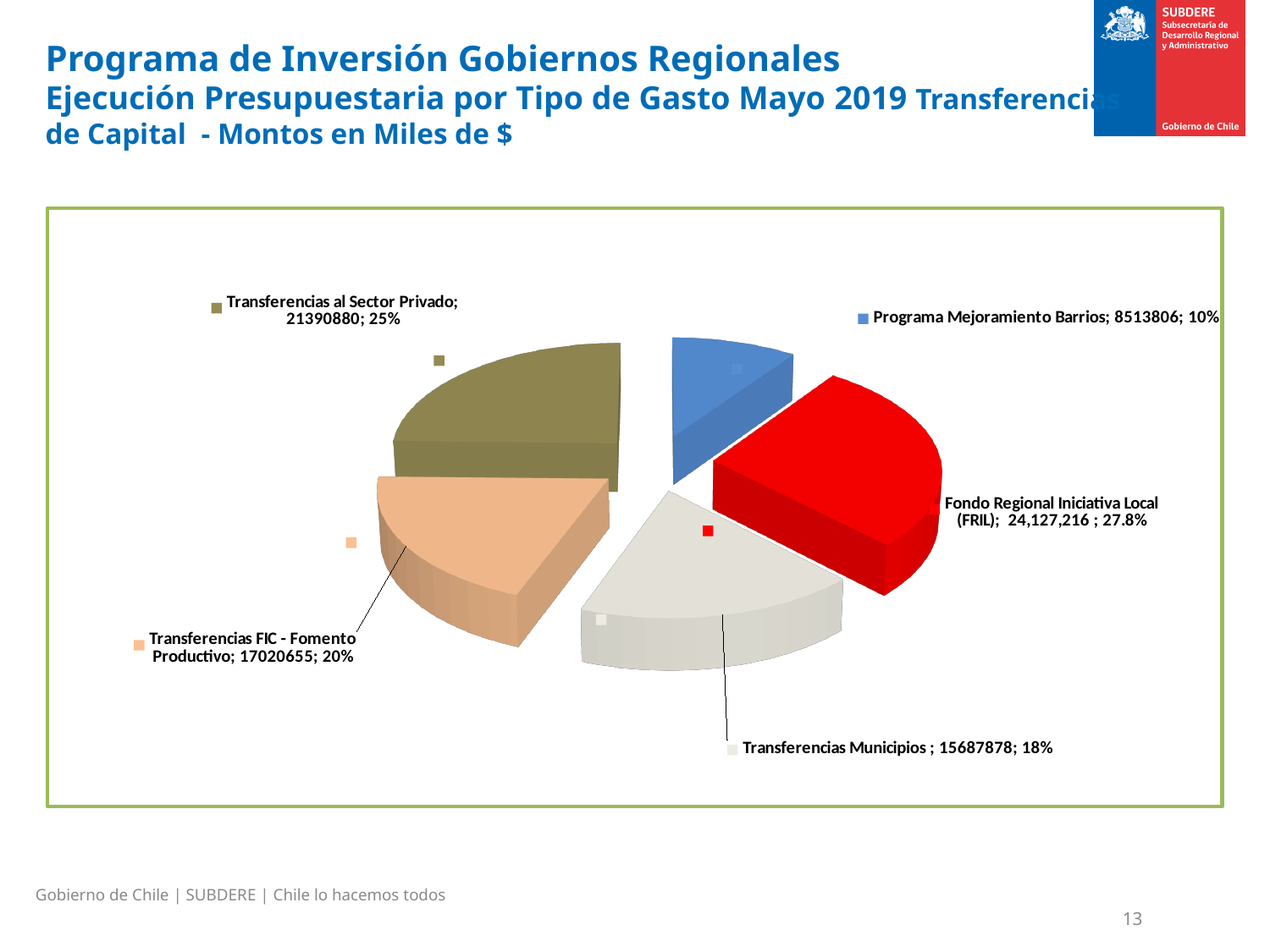
Which is larger, Transferencias FIC - Fomento Productivo or Transferencias Municipios? Transferencias FIC - Fomento Productivo Which category has the smallest slice of the pie? Programa Mejoramiento Barrios What is the difference between the values for Transferencias al Sector Privado and Transferencias Municipios? 5703002 What is the value shown for Programa Mejoramiento Barrios? 8513806 What percentage share of the pie does Transferencias al Sector Privado have? 25% Which category has the largest slice of the pie? Fondo Regional Iniciativa Local (FRIL) What percentage share of the pie does Fondo Regional Iniciativa Local (FRIL) have? 27.8% What is the value shown for Transferencias Municipios? 15687878 What is the value shown for Transferencias FIC - Fomento Productivo? 17020655 What is the value shown for Fondo Regional Iniciativa Local (FRIL)? 24,127,216 What kind of chart is shown on the slide? Pie chart How many slices does the pie chart have? 5